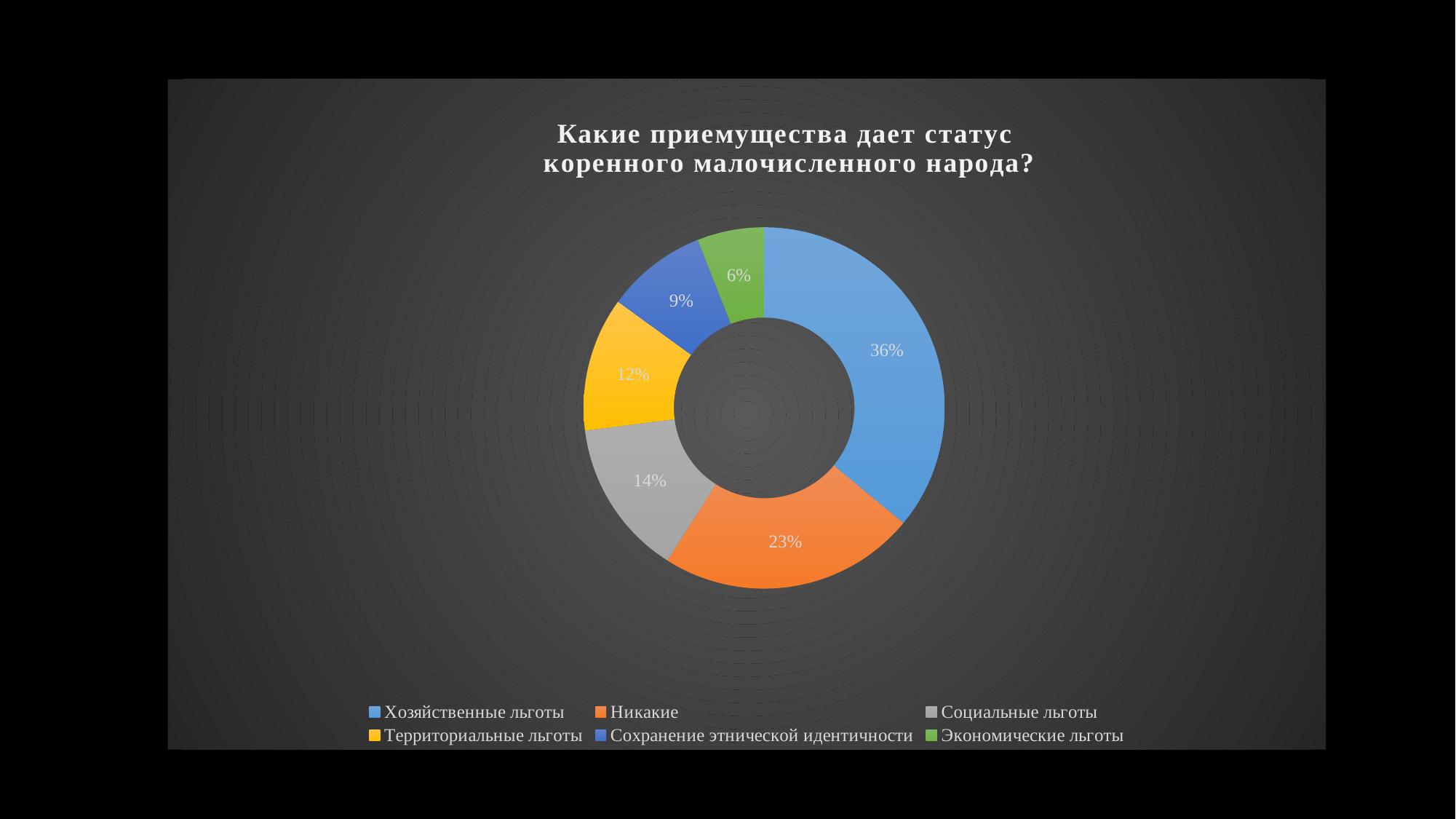
Which category has the largest share? Хозяйственные льготы What is the value for Социальные льготы? 14% What share of the chart does Хозяйственные льготы take? 36% What is the title of the chart? Какие приемущества дает статус коренного малочисленного народа? What kind of chart is shown on the slide? Doughnut chart What is the value for Территориальные льготы? 12% Which category has the smallest share? Экономические льготы What is the difference between the shares of Хозяйственные льготы and Никакие? 13% How many categories does the legend list? 6 What is the value for Никакие? 23% What is the value for Сохранение этнической идентичности? 9% Which is larger, Социальные льготы or Территориальные льготы? Социальные льготы